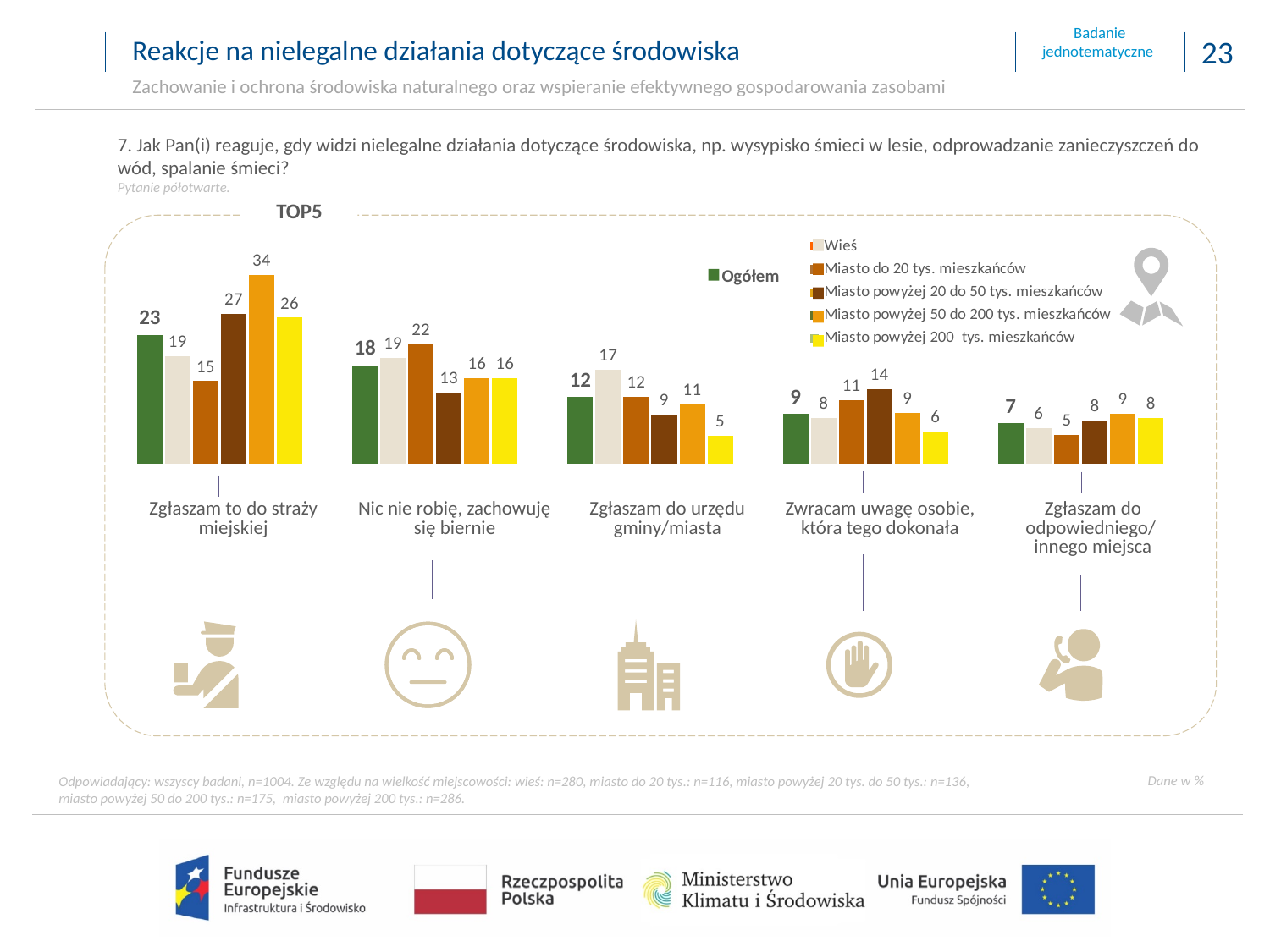
How many response categories are shown in the chart? 5 What is the Ogółem value for "Zgłaszam to do straży miejskiej"? 23 What is the Wieś value for "Zgłaszam do urzędu gminy/miasta"? 17 How many series does the legend list? 6 What is the value for "Miasto powyżej 200 tys. mieszkańców" in the category "Zgłaszam do urzędu gminy/miasta"? 5 In the category "Zwracam uwagę osobie, która tego dokonała", which is larger: the value for "Miasto powyżej 20 do 50 tys. mieszkańców" or the value for Wieś? Miasto powyżej 20 do 50 tys. mieszkańców Which category has the lowest Ogółem value? Zgłaszam do odpowiedniego/innego miejsca Which category has the highest Ogółem value? Zgłaszam to do straży miejskiej Do the Ogółem values rise or fall from left to right across the categories? Fall What kind of chart is shown on the slide? Bar chart What is the difference between the "Miasto powyżej 50 do 200 tys. mieszkańców" value and the Wieś value for "Zgłaszam to do straży miejskiej"? 15 What is the value for "Miasto powyżej 50 do 200 tys. mieszkańców" in the category "Zgłaszam to do straży miejskiej"? 34